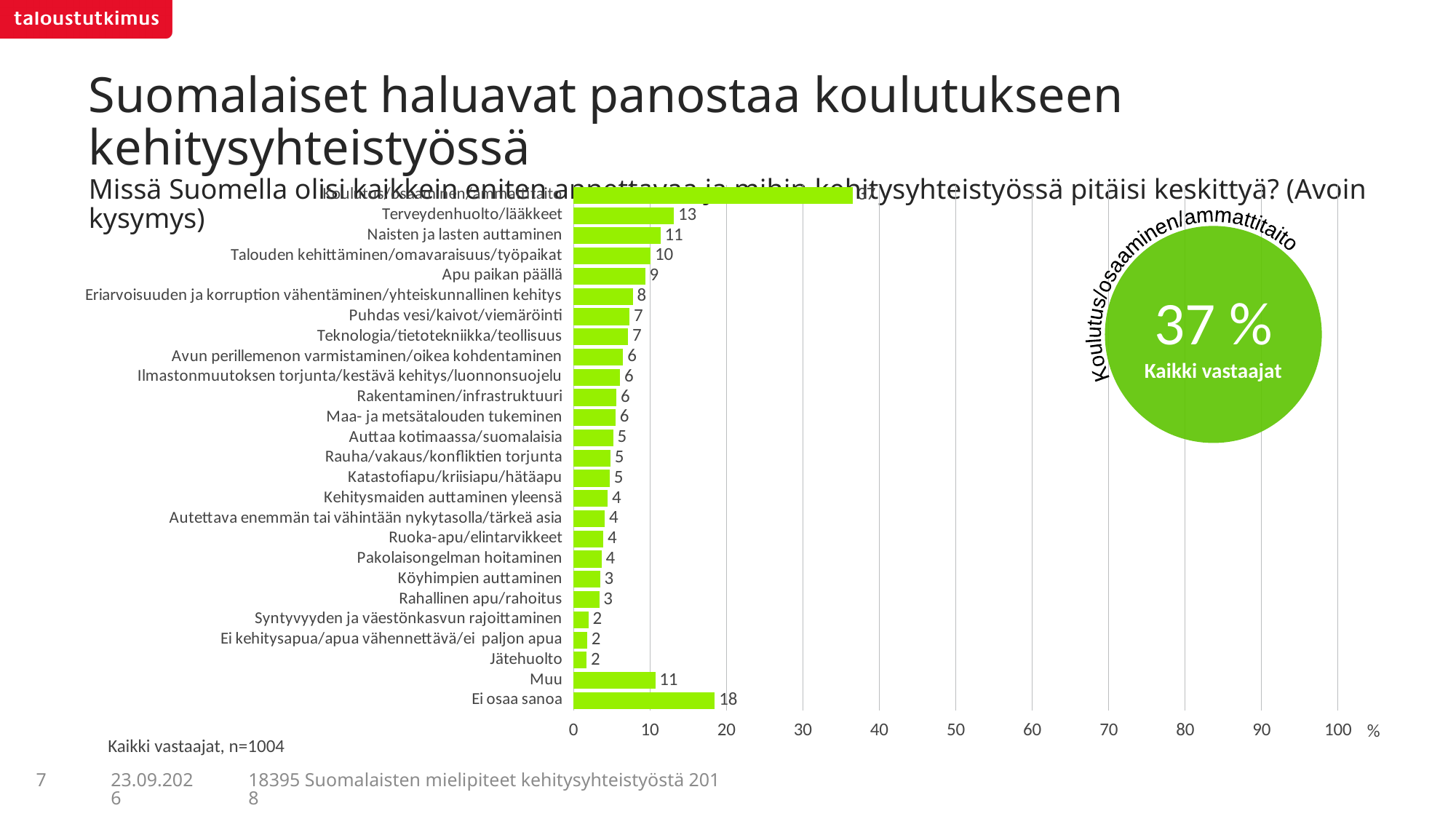
What is the lowest value shown in the bar chart? 2 Is the value for Ei osaa sanoa greater or less than 20? less What percentage of all respondents is shown in the green circle for Koulutus/osaaminen/ammattitaito? 37 % What is the value for Apu paikan päällä? 9 What is the difference between the values for Ei osaa sanoa and Terveydenhuolto/lääkkeet? 5 What is the value for Jätehuolto? 2 What is the value for Terveydenhuolto/lääkkeet? 13 Which is larger, the value for Naisten ja lasten auttaminen or the value for Talouden kehittäminen/omavaraisuus/työpaikat? Naisten ja lasten auttaminen How many categories are shown in the bar chart? 26 What kind of chart is shown on the slide? bar chart What is the value for Ei osaa sanoa? 18 What is the value for Muu? 11